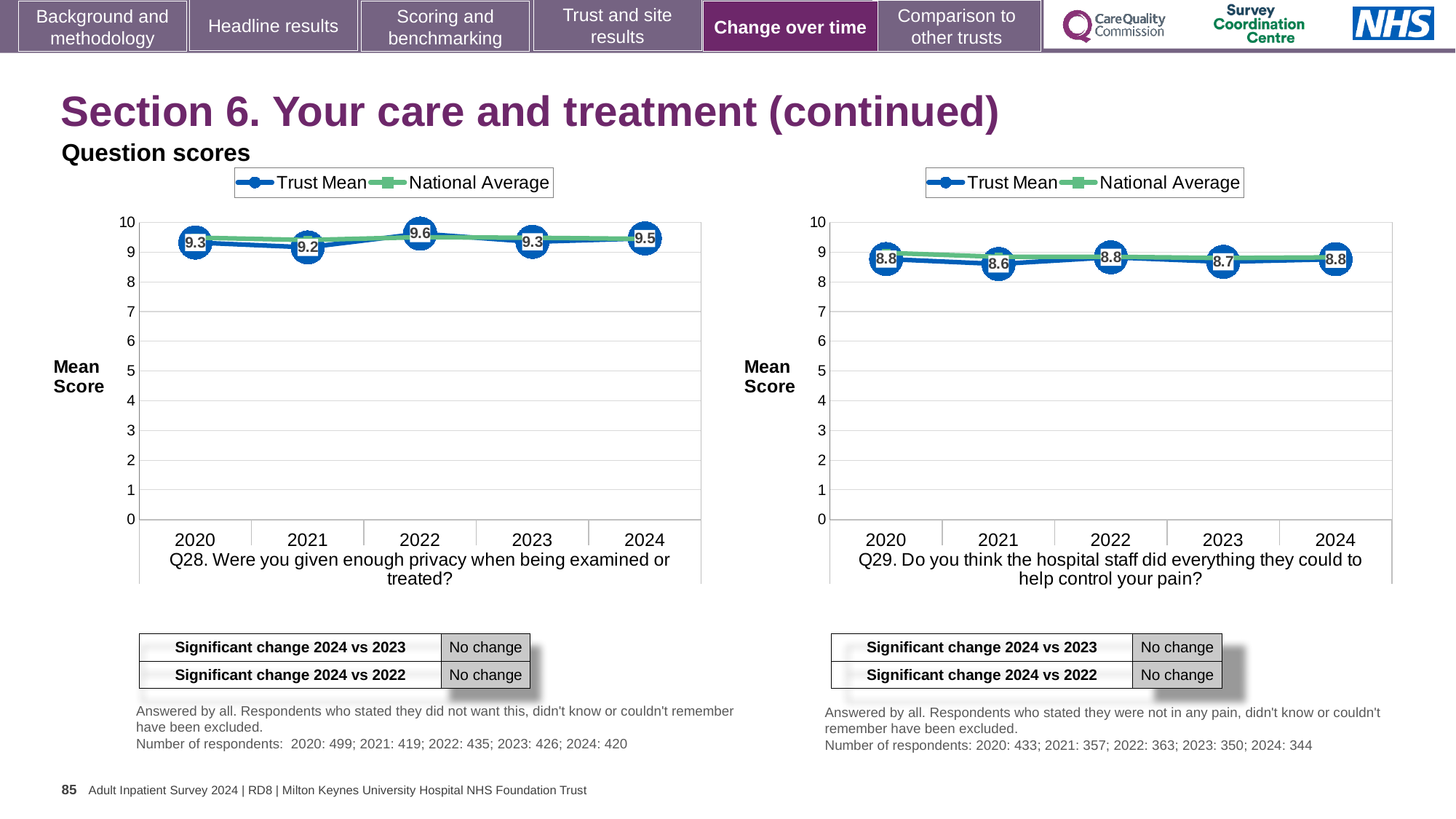
How many series does the legend of the Q28 chart (left) list? 2 On the Q28 chart (left), what is the Trust Mean score for 2021? 9.2 On the Q29 chart (right), is the Trust Mean score for 2024 greater or less than 8? greater On the Q29 chart (right), what is the Trust Mean score for 2024? 8.8 How many years are plotted on the Q29 chart (right)? 5 On the Q28 chart (left), what is the Trust Mean score for 2022? 9.6 On the Q29 chart (right), what is the Trust Mean score for 2021? 8.6 On the Q28 chart (left), what is the difference between the Trust Mean scores for 2022 and 2021? 0.4 On the Q29 chart (right), which year has the lowest Trust Mean score? 2021 What type of chart is used for Q28 (left)? Line chart On the Q28 chart (left), which year has the lowest Trust Mean score? 2021 On the Q28 chart (left), which year has the highest Trust Mean score? 2022